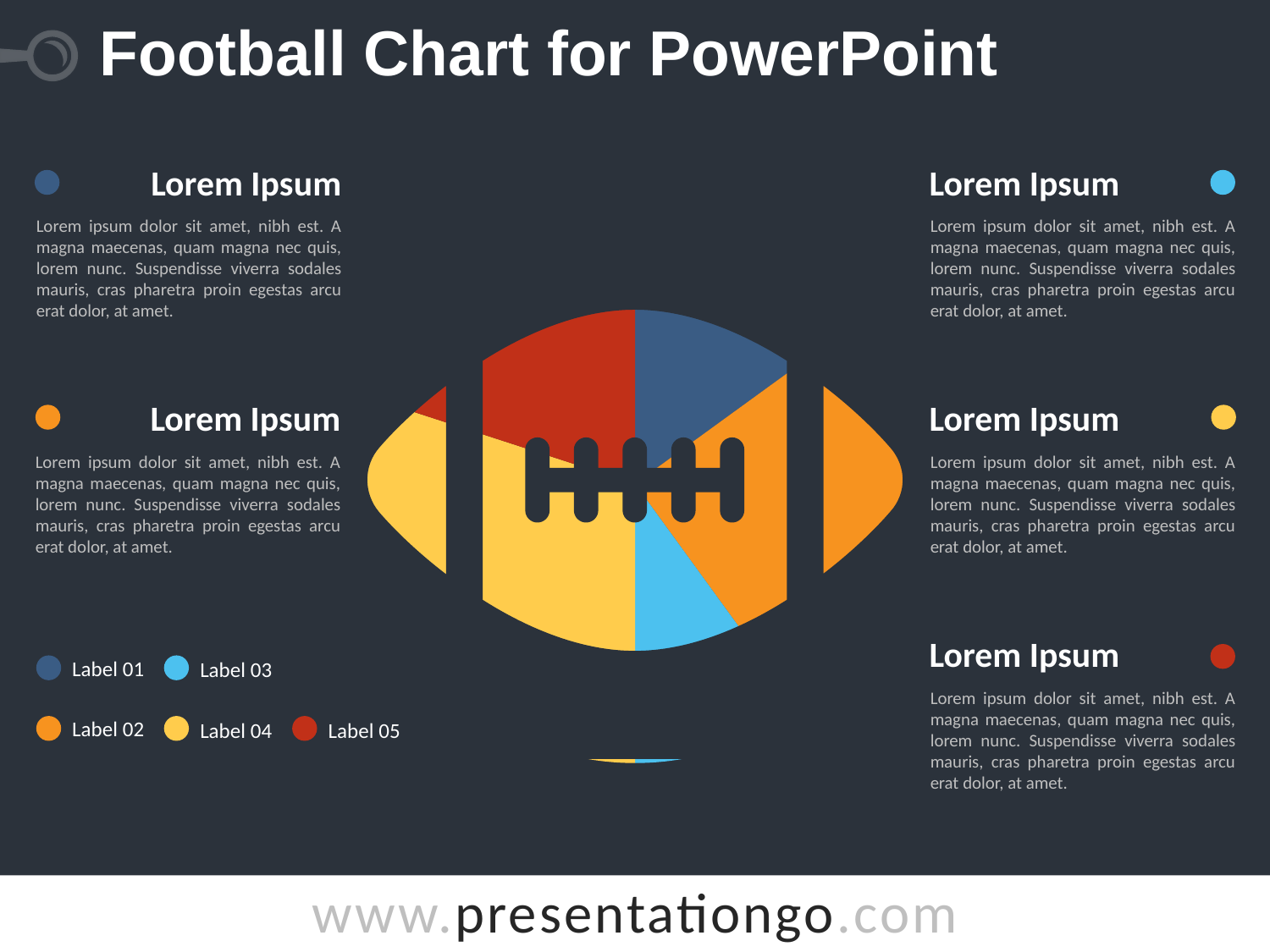
What colour is the Label 05 slice in the football pie chart? red How many entries does the legend of the football pie chart list? 5 In the football pie chart, which slice is larger: Label 04 or Label 05? Label 04 What kind of chart is shown inside the football shape on the slide? pie chart How many categories (slices) does the football pie chart have? 5 Which legend entry in the football pie chart is shown in yellow? Label 04 Which category has the smallest slice in the football pie chart? Label 03 In the football pie chart, which slice is larger: Label 02 or Label 03? Label 02 Which category has the largest slice in the football pie chart? Label 04 In the football pie chart, which slice is larger: Label 04 or Label 03? Label 04